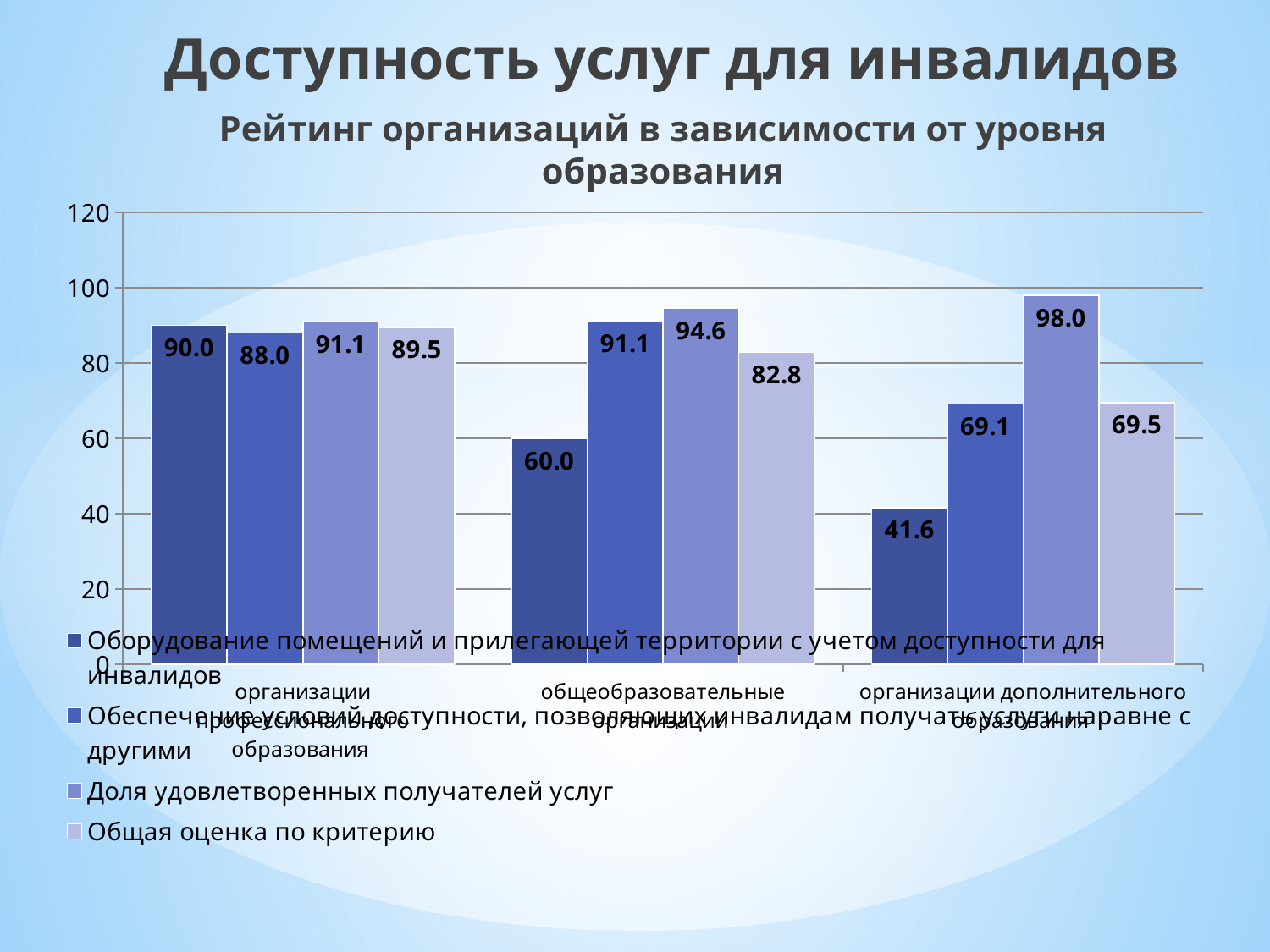
What is the subtitle of the chart? Рейтинг организаций в зависимости от уровня образования What type of chart is shown on the slide? bar chart Which category has the highest value for "Доля удовлетворенных получателей услуг"? организации дополнительного образования What is the value of "Общая оценка по критерию" for "организации профессионального образования"? 89.5 What is the value of "Доля удовлетворенных получателей услуг" for "организации дополнительного образования"? 98.0 What is the difference between the "Общая оценка по критерию" values for "общеобразовательные организации" and "организации дополнительного образования"? 13.3 How many series does the legend list? 4 How many categories are shown on the x axis? 3 What is the value of "Оборудование помещений и прилегающей территории с учетом доступности для инвалидов" for "общеобразовательные организации"? 60.0 Which is larger: "Обеспечение условий доступности, позволяющих инвалидам получать услуги наравне с другими" for "организации профессионального образования" or for "общеобразовательные организации"? общеобразовательные организации Does the value of "Оборудование помещений и прилегающей территории с учетом доступности для инвалидов" fall or rise across the categories from left to right? fall Which category has the lowest value for "Оборудование помещений и прилегающей территории с учетом доступности для инвалидов"? организации дополнительного образования